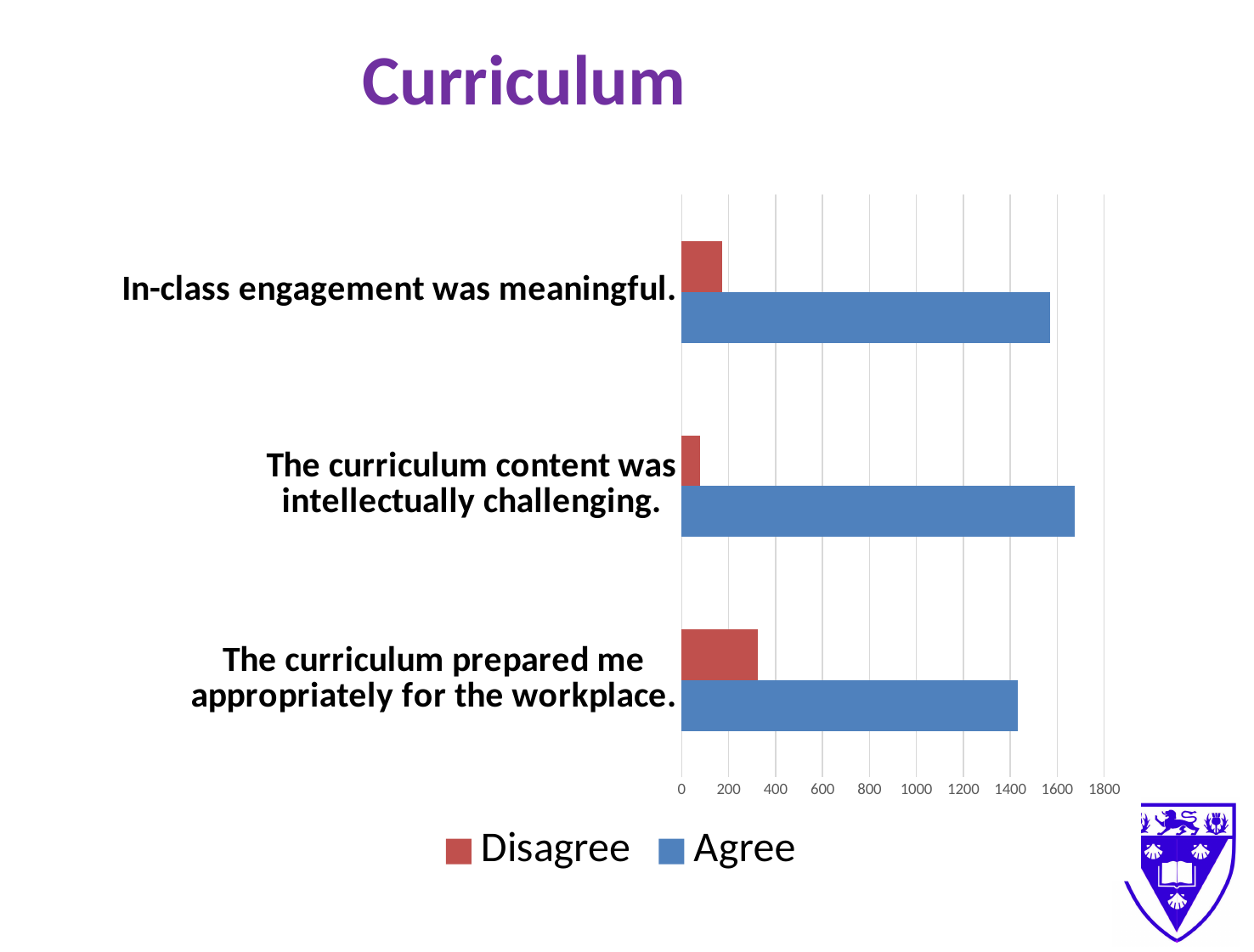
Which statement has the lowest Disagree value? The curriculum content was intellectually challenging. Which statement has the highest Disagree value? The curriculum prepared me appropriately for the workplace. Is the Agree value for "The curriculum prepared me appropriately for the workplace." greater or less than 1600? less Is the Agree value for "The curriculum content was intellectually challenging." greater or less than 1600? greater Is the Disagree value for "The curriculum content was intellectually challenging." greater or less than 200? less How many statements (categories) are plotted in the chart? 3 Which statement has the highest Agree value? The curriculum content was intellectually challenging. What kind of chart is shown on the slide? bar chart Which statement has the lowest Agree value? The curriculum prepared me appropriately for the workplace. How many series does the legend list? 2 Which colour represents the Disagree series in the chart? red